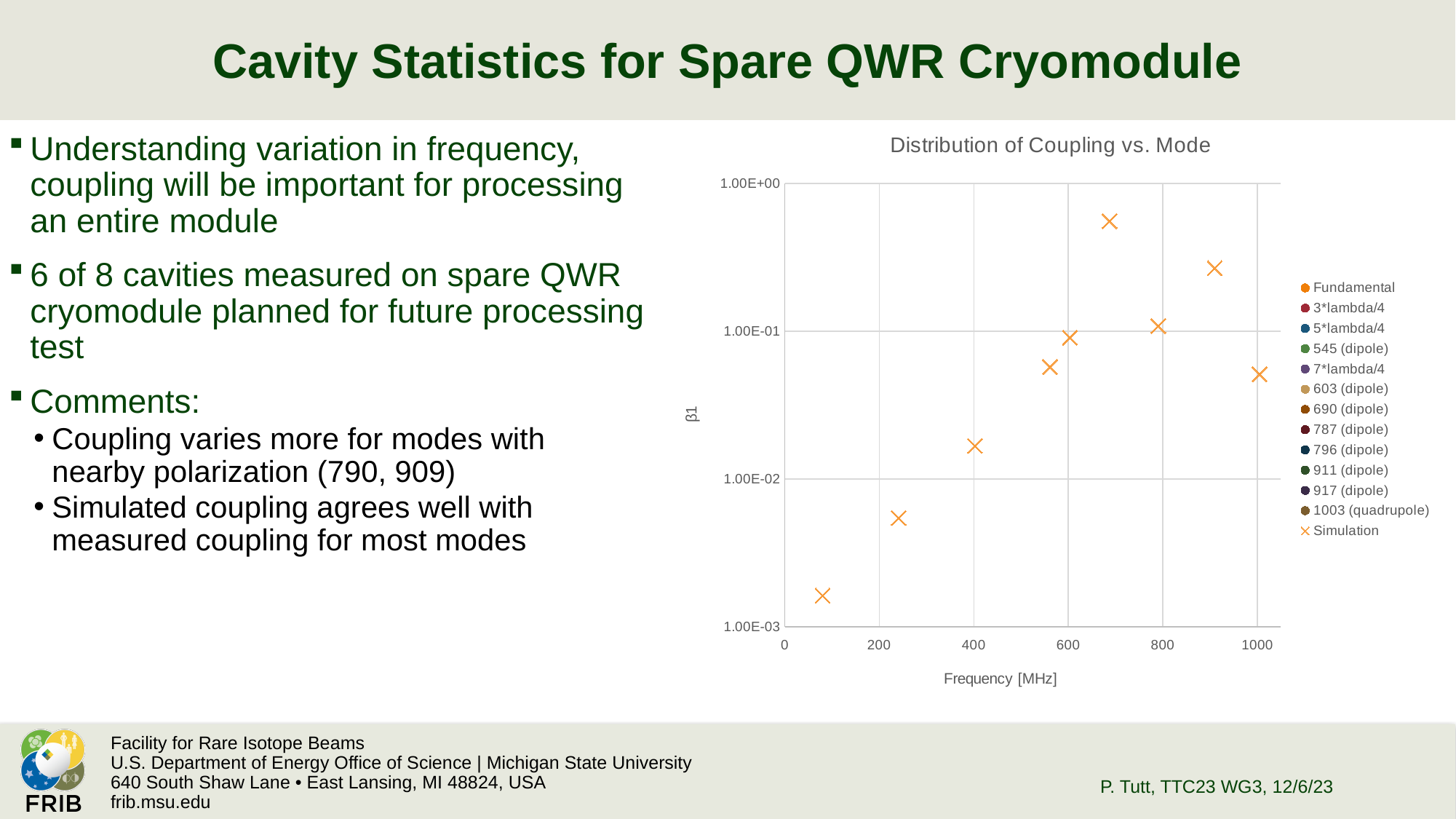
Is the Simulation point near 400 MHz greater or less than 1.00E-02? greater What kind of chart is shown on the slide? scatter plot Which Simulation point has the higher coupling value: the one near 690 MHz or the one near 910 MHz? the one near 690 MHz Is the Simulation point near 80 MHz greater or less than 1.00E-02? less Between which two x-axis ticks does the highest Simulation point lie? 600 and 800 Is the Simulation point near 690 MHz greater or less than 1.00E-01? greater What is the label of the x axis? Frequency [MHz] How many Simulation data points are plotted on the chart? 9 How many series does the chart's legend list? 13 What is the title of the chart? Distribution of Coupling vs. Mode Between which two x-axis ticks does the lowest Simulation point lie? 0 and 200